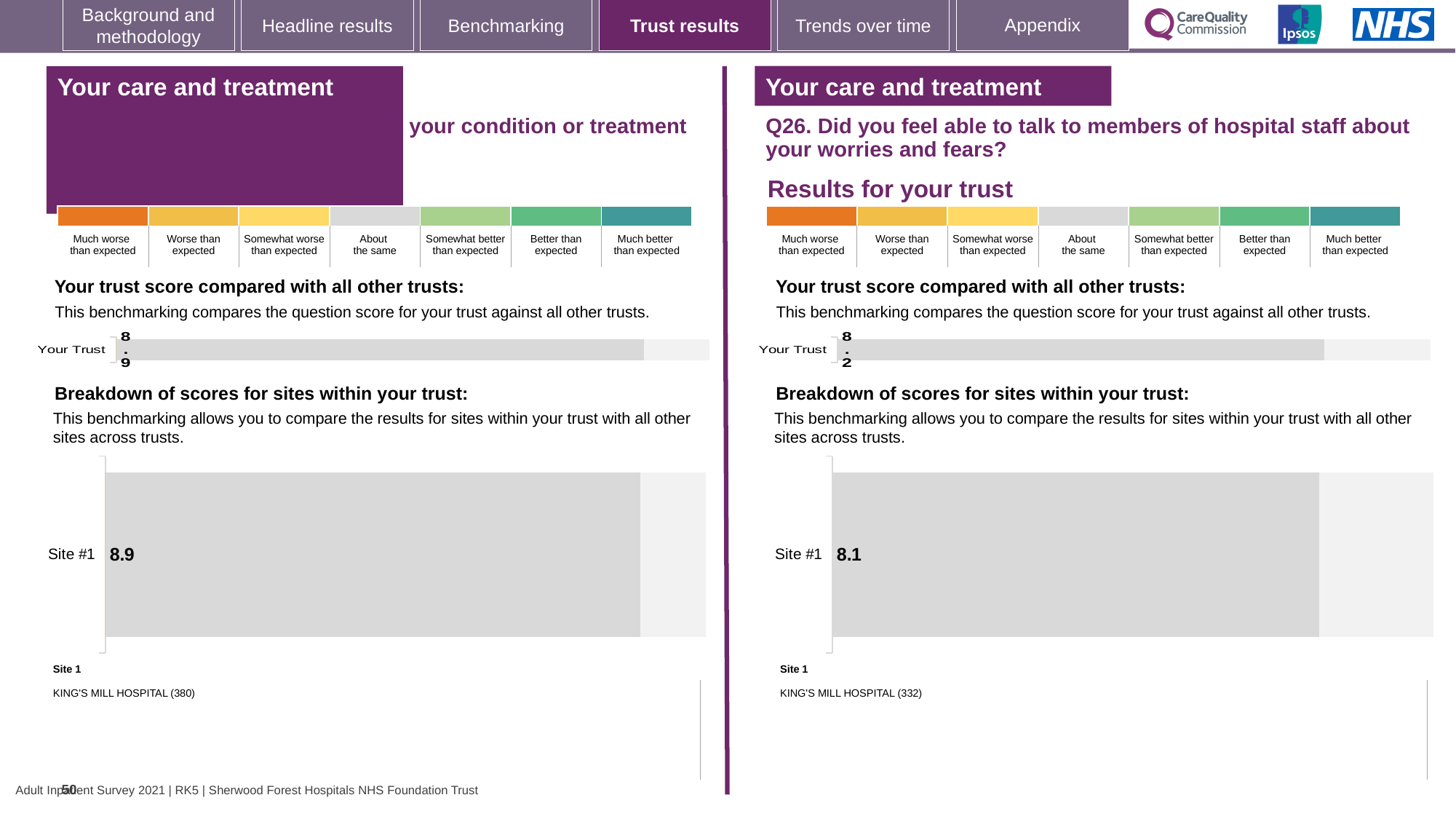
On the right panel (Q26), what score is shown for Site #1 in the 'Breakdown of scores for sites within your trust' chart? 8.1 On the left panel, what is the score shown for Your Trust in the 'Your trust score compared with all other trusts' chart? 8.9 Which is larger: the Your Trust score on the left panel or the Your Trust score on the right panel (Q26)? Left panel (8.9) What type of chart is used to show the Site #1 score on the right panel (Q26)? Bar chart On the left panel, what score is shown for Site #1 in the 'Breakdown of scores for sites within your trust' chart? 8.9 Which hospital is listed as Site 1 on the right panel (Q26)? KING'S MILL HOSPITAL (332) On the left panel, is the Your Trust score greater or less than the Site #1 score, or are they equal? Equal On the right panel (Q26), what is the score shown for Your Trust in the 'Your trust score compared with all other trusts' chart? 8.2 What is the difference between the Site #1 score on the left panel and the Site #1 score on the right panel (Q26)? 0.8 On the right panel (Q26), what is the difference between the Your Trust score and the Site #1 score? 0.1 How many sites are shown in the 'Breakdown of scores for sites within your trust' chart on the left panel? 1 How many categories are shown in the colour scale legend above the charts on the left panel, from 'Much worse than expected' to 'Much better than expected'? 7